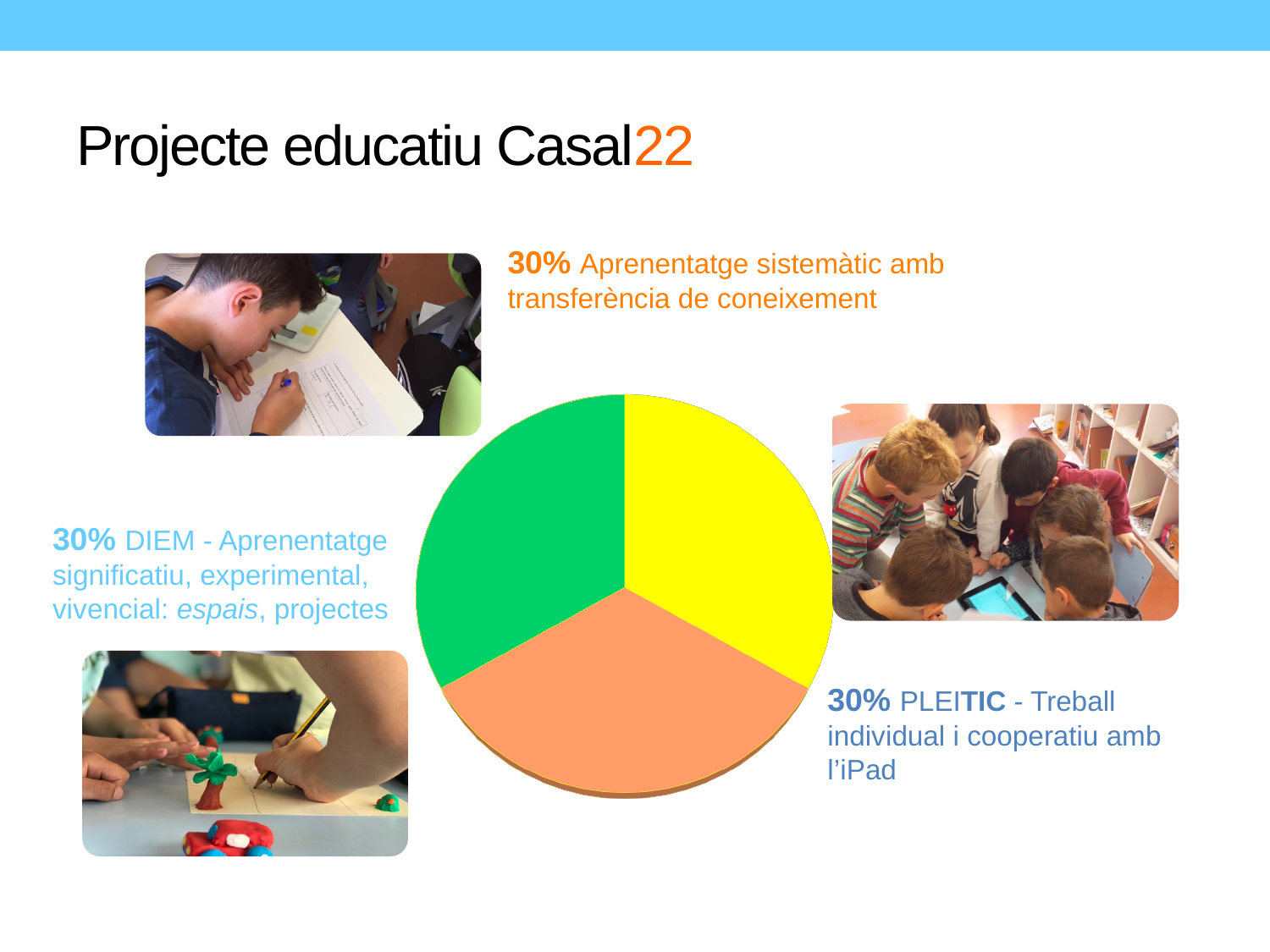
What percentage is shown for 'DIEM - Aprenentatge significatiu, experimental, vivencial'? 30% What percentage is shown for 'PLEITIC - Treball individual i cooperatiu amb l'iPad'? 30% What percentage is shown for 'Aprenentatge sistemàtic amb transferència de coneixement'? 30% Are the three slices of the pie chart roughly equal in size? yes How many slices does the pie chart have? 3 What kind of chart is shown on the slide? pie chart What is the difference between the percentage for DIEM and the percentage for PLEITIC? 0% What colours are the three slices of the pie chart? yellow, green and orange